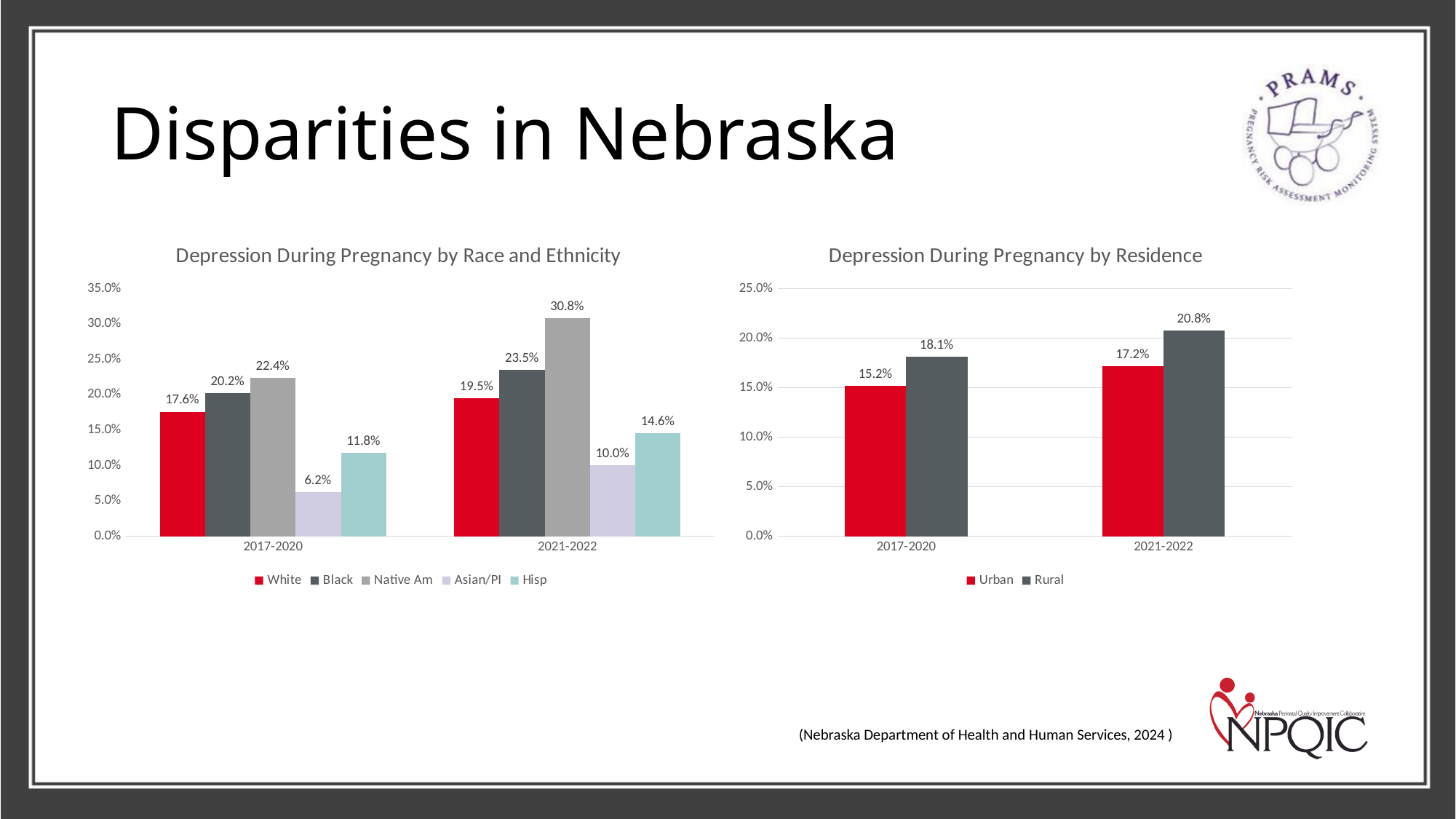
In the 'Depression During Pregnancy by Residence' chart, what is the Rural value for 2021-2022? 20.8% In the 'Depression During Pregnancy by Residence' chart, which is larger in 2021-2022, Urban or Rural? Rural In the 'Depression During Pregnancy by Race and Ethnicity' chart, what is the value for Native Am in 2021-2022? 30.8% In the 'Depression During Pregnancy by Race and Ethnicity' chart, what is the value for Asian/PI in 2017-2020? 6.2% In the 'Depression During Pregnancy by Race and Ethnicity' chart, which group has the lowest value in 2021-2022? Asian/PI In the 'Depression During Pregnancy by Race and Ethnicity' chart, what is the difference between the Black values for 2021-2022 and 2017-2020? 3.3% In the 'Depression During Pregnancy by Race and Ethnicity' chart, does the Hisp value rise or fall from 2017-2020 to 2021-2022? rise In the 'Depression During Pregnancy by Residence' chart, what is the difference between the Rural and Urban values for 2017-2020? 2.9% How many series does the legend of the 'Depression During Pregnancy by Race and Ethnicity' chart list? 5 What type of chart is the 'Depression During Pregnancy by Residence' chart? bar chart In the 'Depression During Pregnancy by Residence' chart, which colour represents Urban? red In the 'Depression During Pregnancy by Race and Ethnicity' chart, which group has the highest value in 2017-2020? Native Am